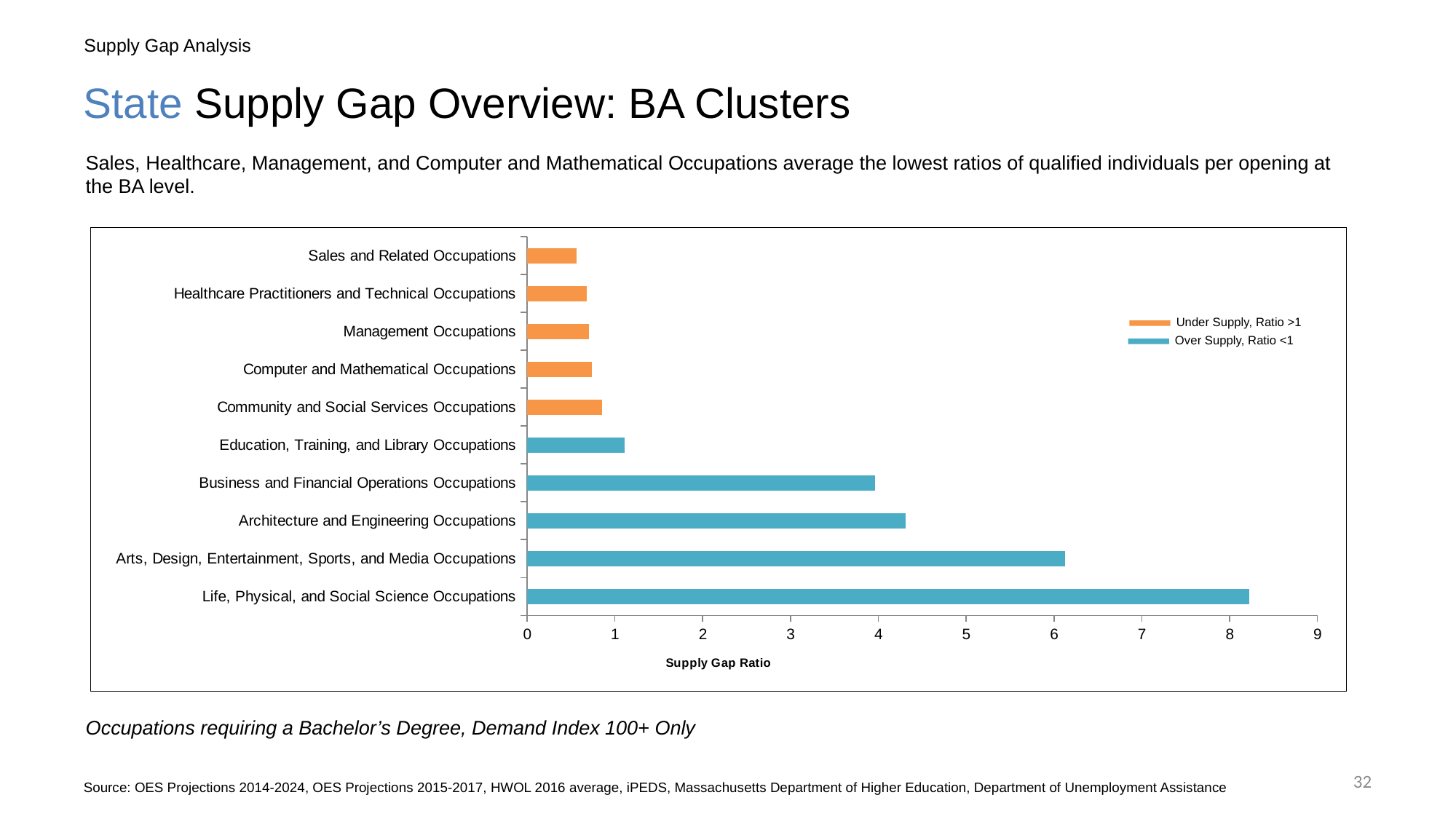
Is the supply gap ratio for Architecture and Engineering Occupations greater or less than 4? greater Is the supply gap ratio for Community and Social Services Occupations greater or less than 1? less Which occupation category has the highest supply gap ratio? Life, Physical, and Social Science Occupations How many occupation categories are plotted in the chart? 10 Which legend entry is shown in orange? Under Supply, Ratio >1 Is the supply gap ratio for Life, Physical, and Social Science Occupations greater or less than 8? greater How many series does the chart legend list? 2 Which has a larger supply gap ratio: Business and Financial Operations Occupations or Education, Training, and Library Occupations? Business and Financial Operations Occupations Which occupation category has the lowest supply gap ratio? Sales and Related Occupations What kind of chart is shown on the slide? bar chart What is the title of the horizontal axis of the chart? Supply Gap Ratio